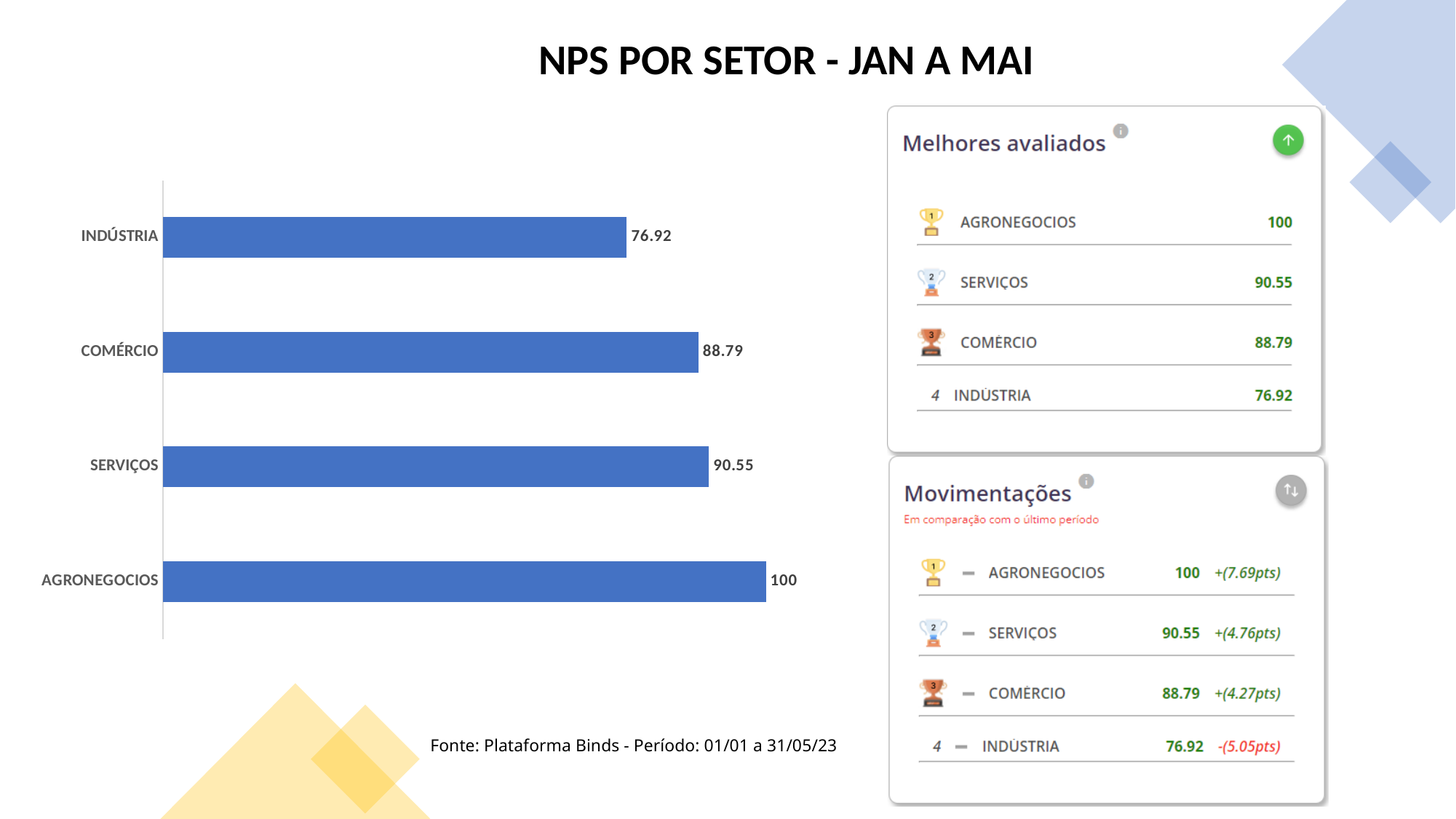
Which has a higher NPS, COMÉRCIO or INDÚSTRIA? COMÉRCIO Which sector has the lowest NPS? INDÚSTRIA What is the difference between the NPS of SERVIÇOS and COMÉRCIO? 1.76 What kind of chart is shown on the slide? Bar chart What is the NPS value for INDÚSTRIA? 76.92 What is the title of the slide? NPS POR SETOR - JAN A MAI Which sector has the highest NPS? AGRONEGOCIOS What is the NPS value for COMÉRCIO? 88.79 What is the NPS value for SERVIÇOS? 90.55 How many sectors are shown in the chart? 4 What is the NPS value for AGRONEGOCIOS? 100 What is the difference between the NPS of AGRONEGOCIOS and INDÚSTRIA? 23.08